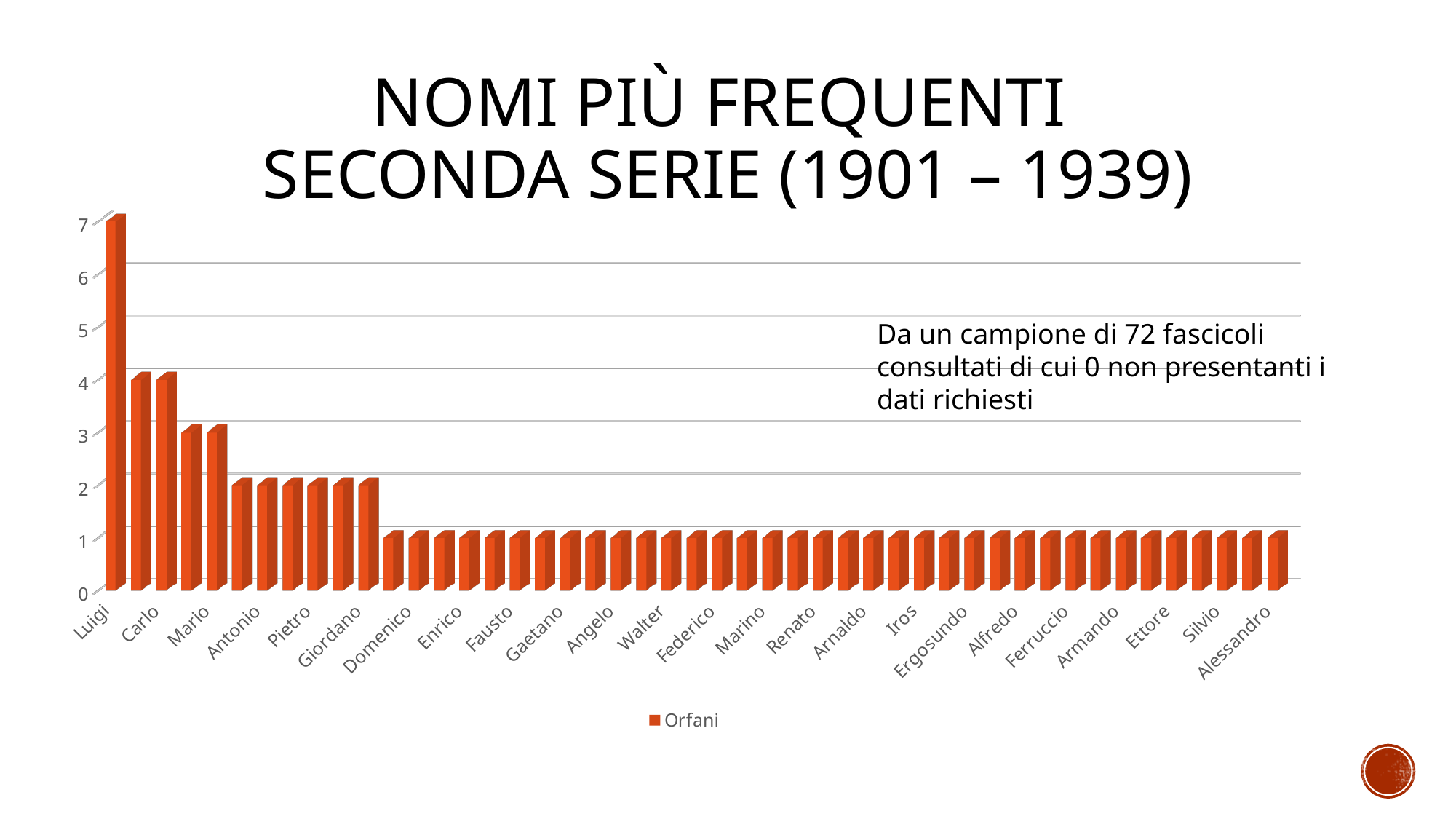
What is the difference between the values for Luigi and Carlo? 3 What is the value for Mario? 3 What is the value for Antonio? 2 How many series does the legend list? 1 Which is larger, the value for Carlo or the value for Mario? Carlo What is the value for Domenico? 1 What is the value for Carlo? 4 Is the value for Luigi greater or less than 6? greater What kind of chart is shown on the slide? bar chart Do the values rise or fall from left to right along the x axis? fall Which name has the highest bar? Luigi What is the value for Luigi? 7